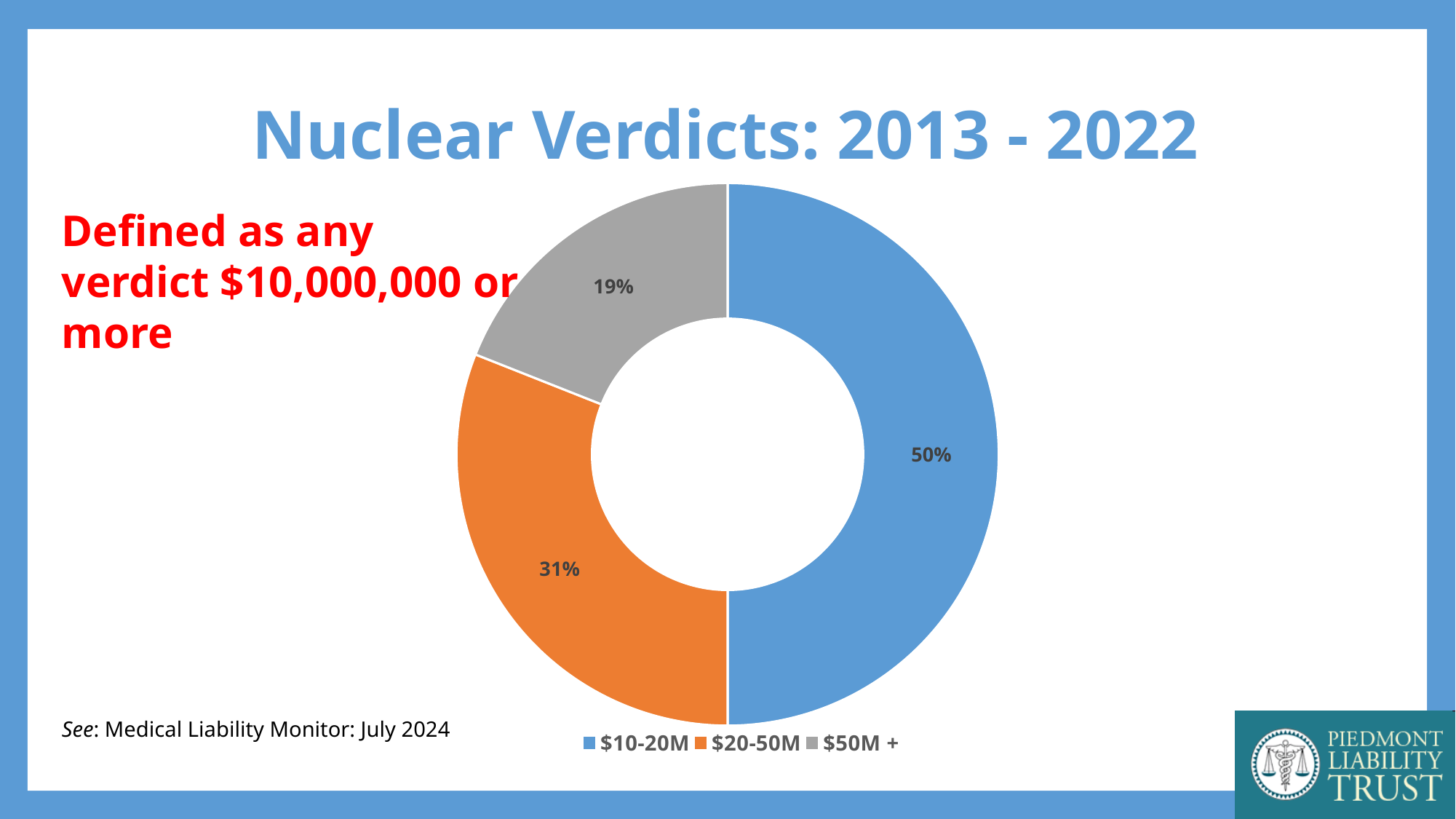
Which verdict range has the largest share of the chart? $10-20M What is the difference in percentage points between the $20-50M share and the $50M + share? 12 What share of nuclear verdicts falls in the $10-20M range? 50% What share of nuclear verdicts falls in the $20-50M range? 31% What share of nuclear verdicts falls in the $50M + range? 19% What kind of chart is shown on the slide? Doughnut chart What is the difference in percentage points between the $10-20M share and the $20-50M share? 19 How many verdict ranges are shown in the chart? 3 Which verdict range has the smallest share of the chart? $50M + Which is larger, the share for $20-50M or the share for $50M +? $20-50M What is the title of the slide containing the chart? Nuclear Verdicts: 2013 - 2022 What colour represents the $20-50M range in the chart? Orange